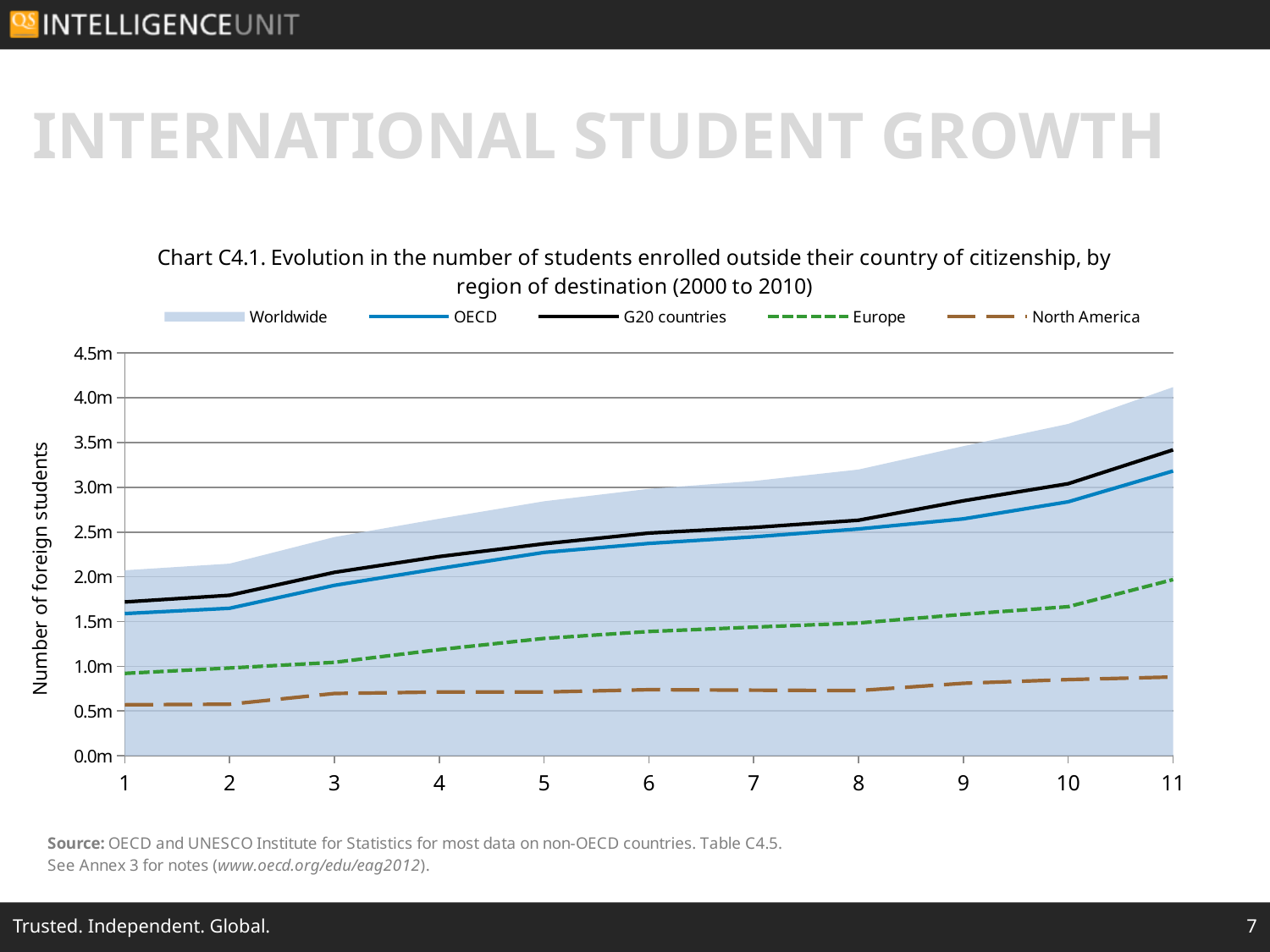
Is the value for Europe at x = 6 greater or less than 1.0m? greater Which series has the lowest value at x = 11? North America How many series does the legend list? 5 How many points are there along the x axis? 11 What is the label of the y axis? Number of foreign students At x = 11, which is larger: G20 countries or OECD? G20 countries Do the Worldwide values rise or fall from x = 1 to x = 11? rise Is the value for North America at x = 11 greater or less than 1.0m? less What kind of chart is shown on the slide? combination area and line chart Is the value for G20 countries at x = 1 greater or less than 2.0m? less Which series has the highest value at x = 11? Worldwide